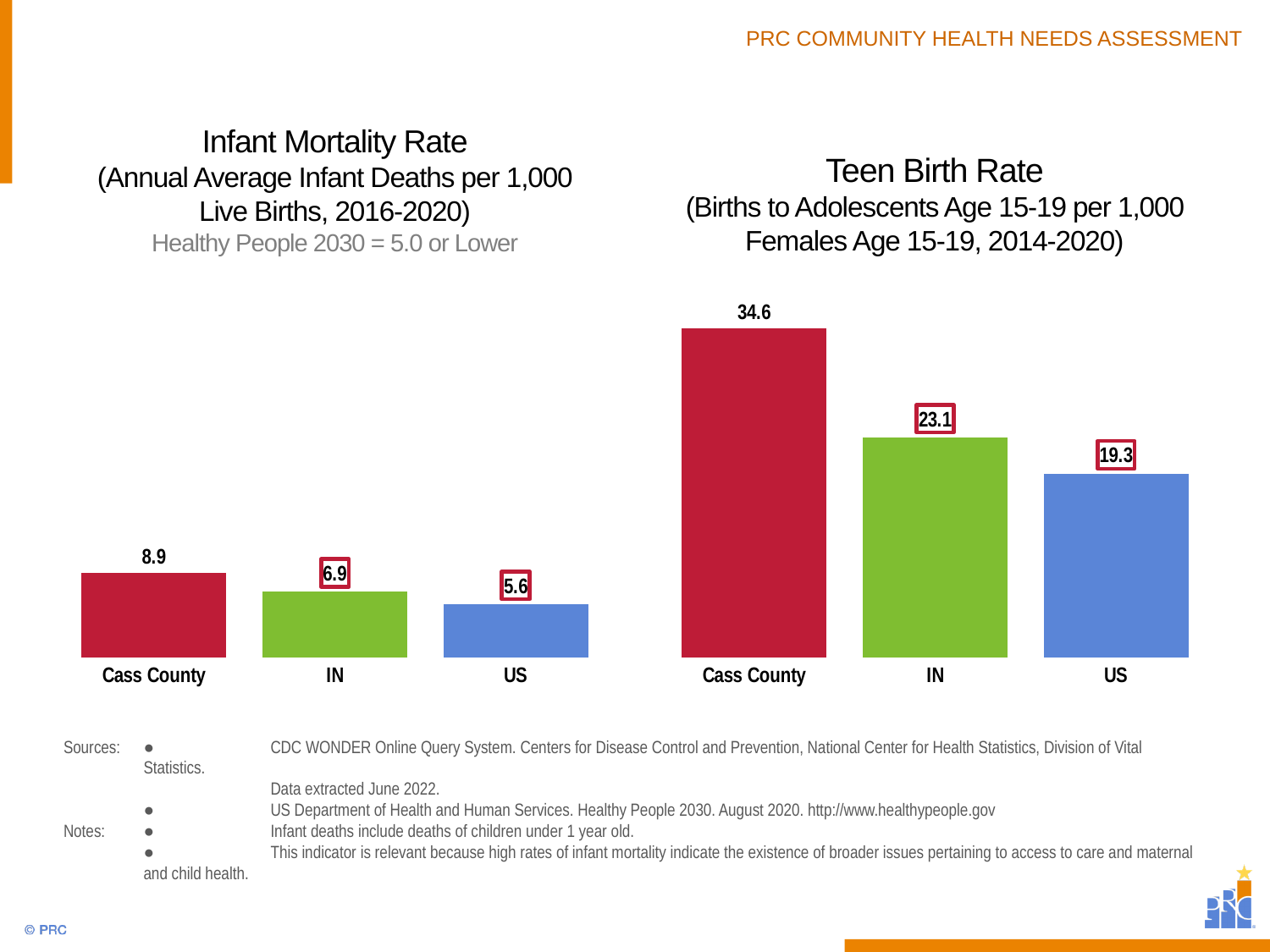
In the Infant Mortality Rate chart, what is the value for IN? 6.9 In the Infant Mortality Rate chart, what is the value for US? 5.6 In the Infant Mortality Rate chart, what is the difference between the Cass County value and the US value? 3.3 In the Infant Mortality Rate chart, what is the value for Cass County? 8.9 In the Teen Birth Rate chart, what is the difference between the Cass County value and the IN value? 11.5 In the Teen Birth Rate chart, what is the value for Cass County? 34.6 In the Teen Birth Rate chart, what is the value for US? 19.3 In the Infant Mortality Rate chart, which category has the lowest value? US How many categories are shown in the Infant Mortality Rate chart? 3 In the Teen Birth Rate chart, which is larger, the value for IN or the value for US? IN What kind of chart is the Teen Birth Rate chart? Bar chart In the Teen Birth Rate chart, which category has the highest value? Cass County